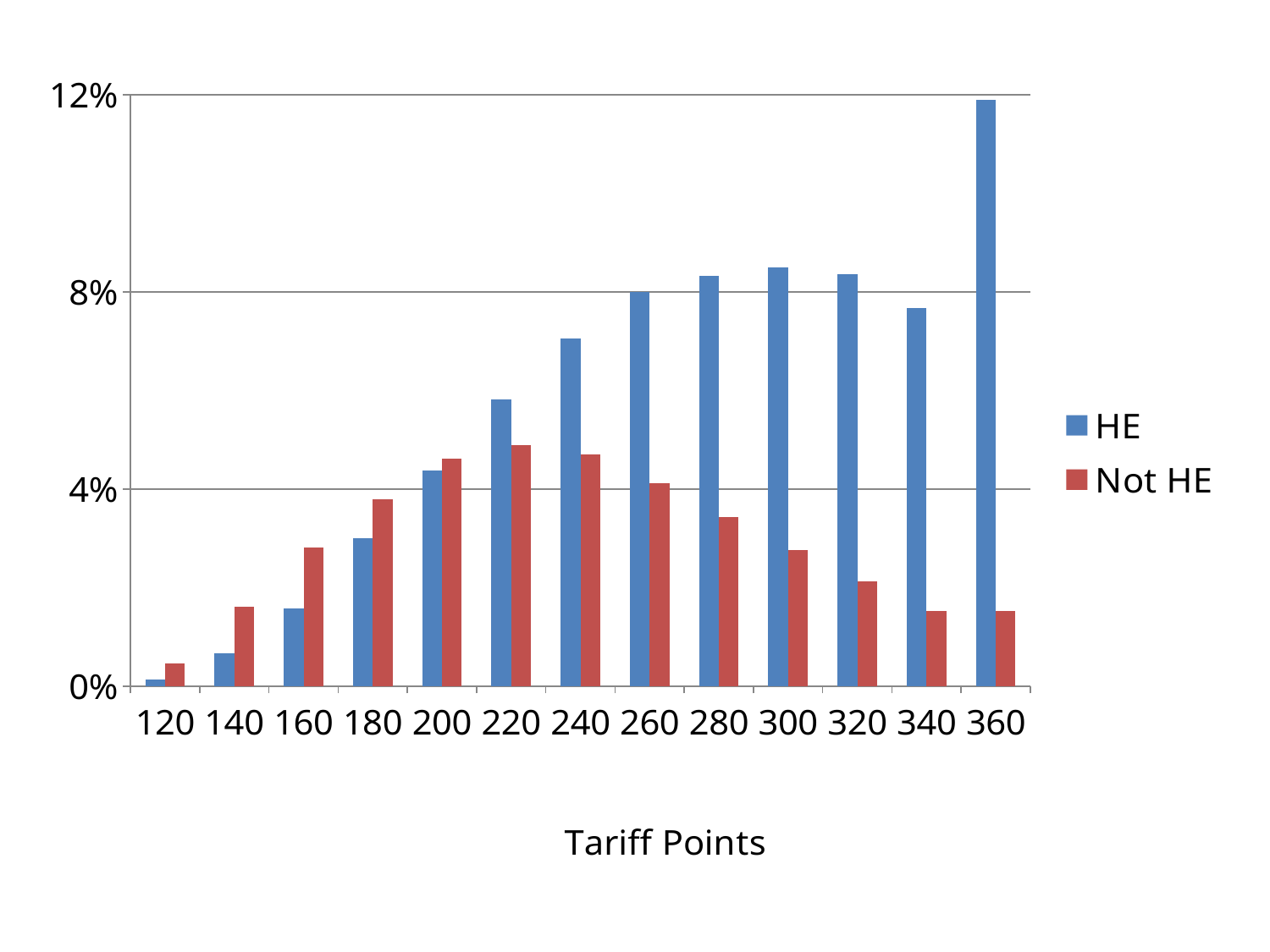
How many tariff point categories are shown on the x axis? 13 What kind of chart is shown on the slide? bar chart At 180 tariff points, which series has the larger value, HE or Not HE? Not HE Is the Not HE value at 180 tariff points greater or less than 4%? less At which tariff points value is the HE series lowest? 120 Is the HE value at 220 tariff points greater or less than 4%? greater Is the HE value at 360 tariff points greater or less than 8%? greater How many series does the legend list? 2 At 300 tariff points, which series has the larger value, HE or Not HE? HE What is the title of the x axis? Tariff Points At which tariff points value is the HE series highest? 360 At which tariff points value is the Not HE series lowest? 120